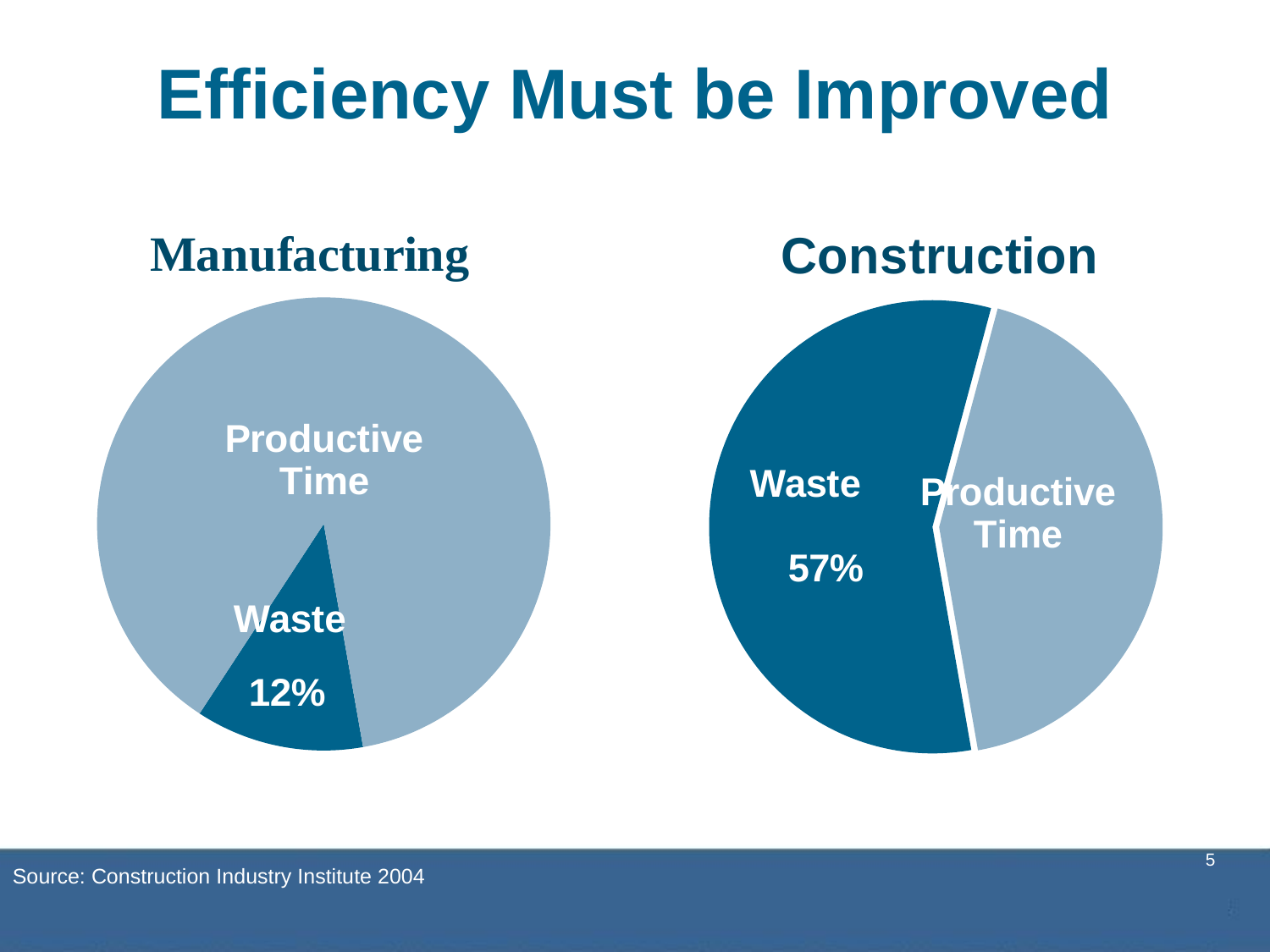
In the Manufacturing pie chart, what share of the pie is Waste? 12% What kind of chart is used for the Manufacturing data? Pie chart What is the title of the slide containing the two pie charts? Efficiency Must be Improved In the Manufacturing pie chart, which slice is the smallest? Waste Which chart shows the higher Waste percentage, Manufacturing or Construction? Construction In the Construction pie chart, which slice is larger, Waste or Productive Time? Waste In the Construction pie chart, which slice is the largest? Waste What is the difference between the Waste percentage in the Construction chart and the Waste percentage in the Manufacturing chart? 45 percentage points In the Manufacturing pie chart, which slice is larger, Productive Time or Waste? Productive Time How many slices does the Construction pie chart have? 2 In the Construction pie chart, what share of the pie is Waste? 57% How many slices does the Manufacturing pie chart have? 2